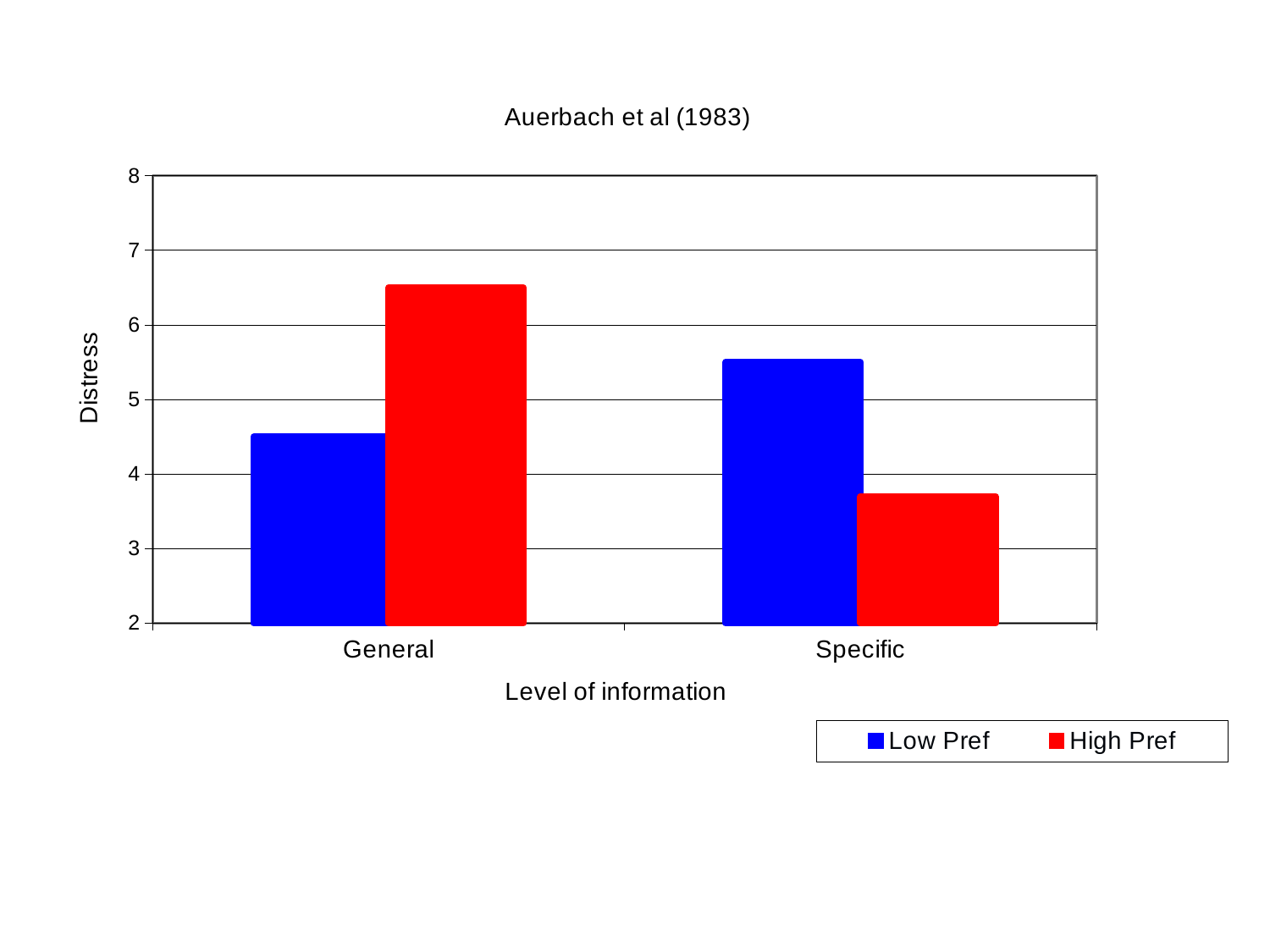
For the General category, which is larger: Low Pref or High Pref? High Pref Is the High Pref value for General greater or less than 6? greater Which bar is the lowest on the chart? High Pref, Specific For the Specific category, which is larger: Low Pref or High Pref? Low Pref How many categories are shown on the x axis? 2 What kind of chart is shown on the slide? bar chart How many series does the legend list? 2 Is the High Pref value for Specific greater or less than 4? less Which bar is the highest on the chart? High Pref, General What is the label of the y axis? Distress What is the title of the chart? Auerbach et al (1983) Does the High Pref series rise or fall from General to Specific? fall